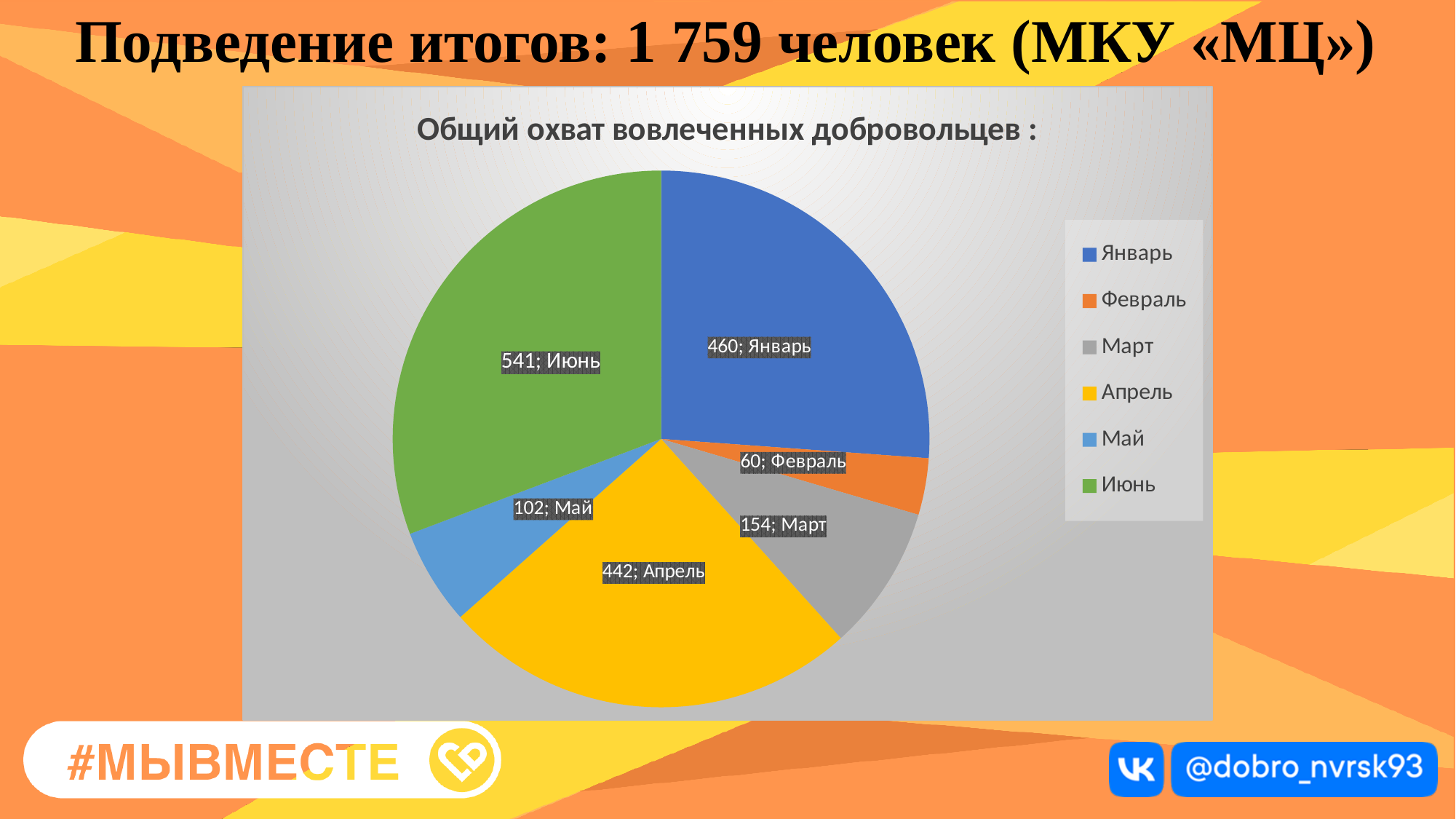
Which month has the smallest slice in the pie chart? Февраль What is the value for Январь in the pie chart? 460 How many months (slices) are shown in the pie chart? 6 What is the value for Май in the pie chart? 102 What is the title of the chart? Общий охват вовлеченных добровольцев : What type of chart is shown on the slide? pie chart What is the value for Апрель in the pie chart? 442 Which month has the largest slice in the pie chart? Июнь What is the difference between the values for Июнь and Январь? 81 What is the difference between the values for Март and Май? 52 Which is larger, the value for Январь or the value for Апрель? Январь What is the value for Февраль in the pie chart? 60